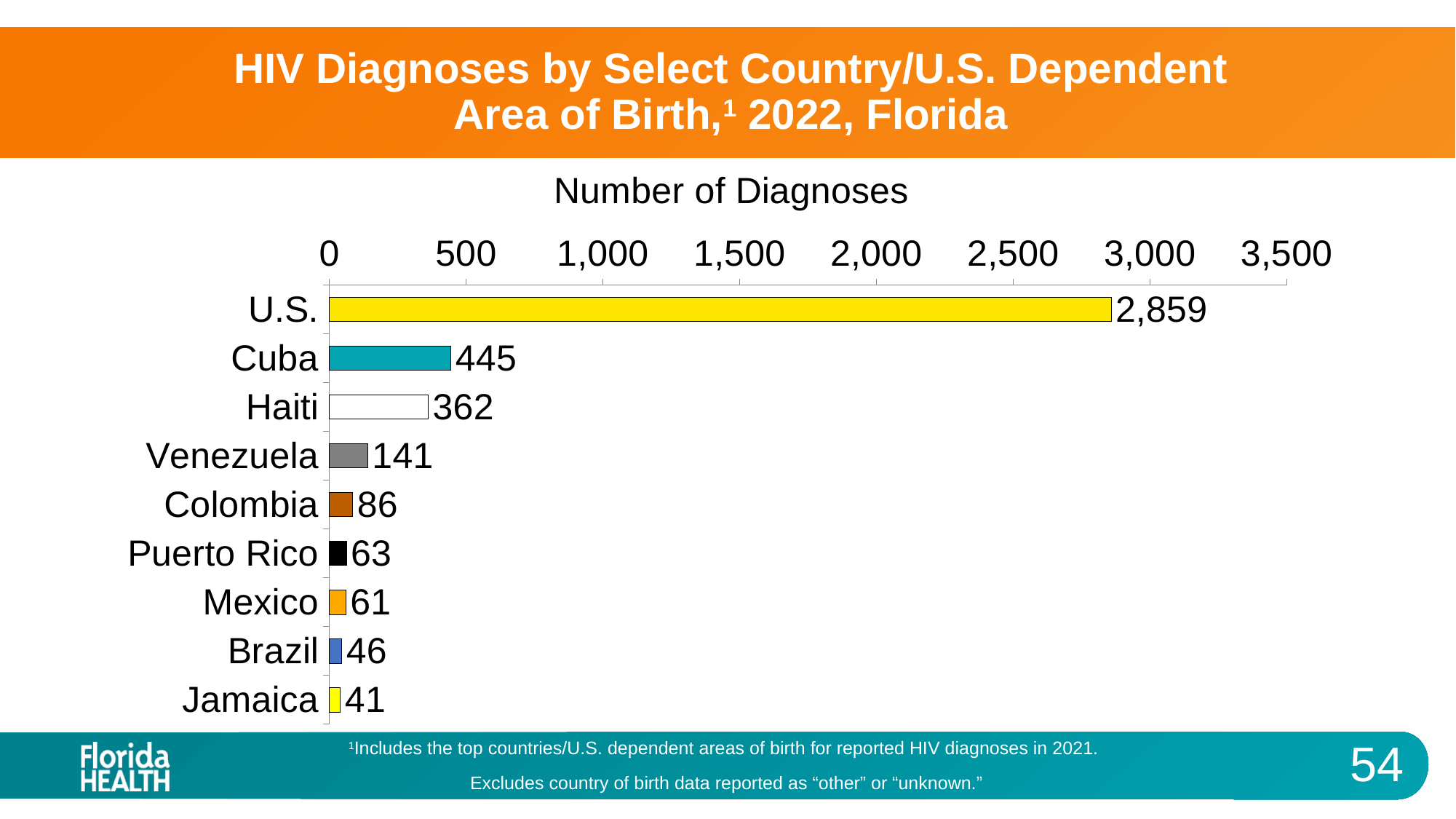
Which country/area of birth has the highest number of diagnoses? U.S. What is the number of diagnoses for Venezuela? 141 What is the axis title shown above the chart? Number of Diagnoses Which has more diagnoses, Colombia or Puerto Rico? Colombia What is the difference in diagnoses between the U.S. and Cuba? 2,414 What is the number of diagnoses for Haiti? 362 What is the difference in diagnoses between Cuba and Haiti? 83 Is the value for the U.S. greater or less than 2,500? greater Which country/area of birth has the lowest number of diagnoses? Jamaica How many HIV diagnoses were reported for people born in Cuba? 445 What kind of chart is shown on the slide? Bar chart How many countries/areas of birth are shown in the chart? 9